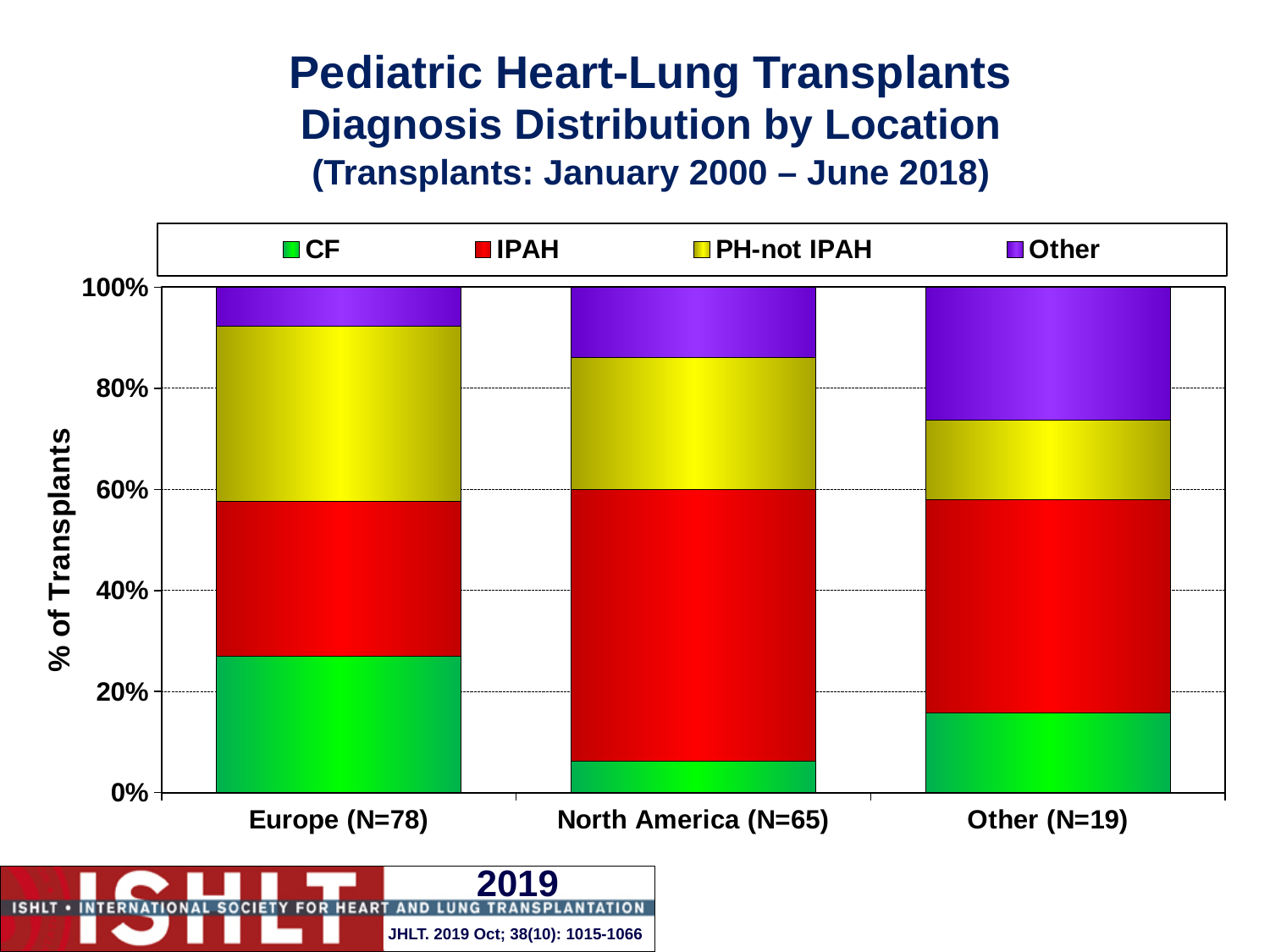
Is the PH-not IPAH share for Europe (N=78) larger or smaller than that for Other (N=19)? larger Which location has the smallest CF share of transplants? North America (N=65) How many diagnosis series does the legend list? 4 Is the CF share for North America (N=65) greater or less than 20%? less How many location categories are shown on the x axis? 3 Is the CF share for Europe (N=78) greater or less than 20%? greater Which location has the largest 'Other' diagnosis share of transplants? Other (N=19) What is the label on the y axis? % of Transplants Which diagnosis categories are listed in the legend? CF, IPAH, PH-not IPAH, Other What kind of chart is shown on the slide? Stacked bar chart Which location has the largest CF share of transplants? Europe (N=78) Which location has the largest IPAH share of transplants? North America (N=65)